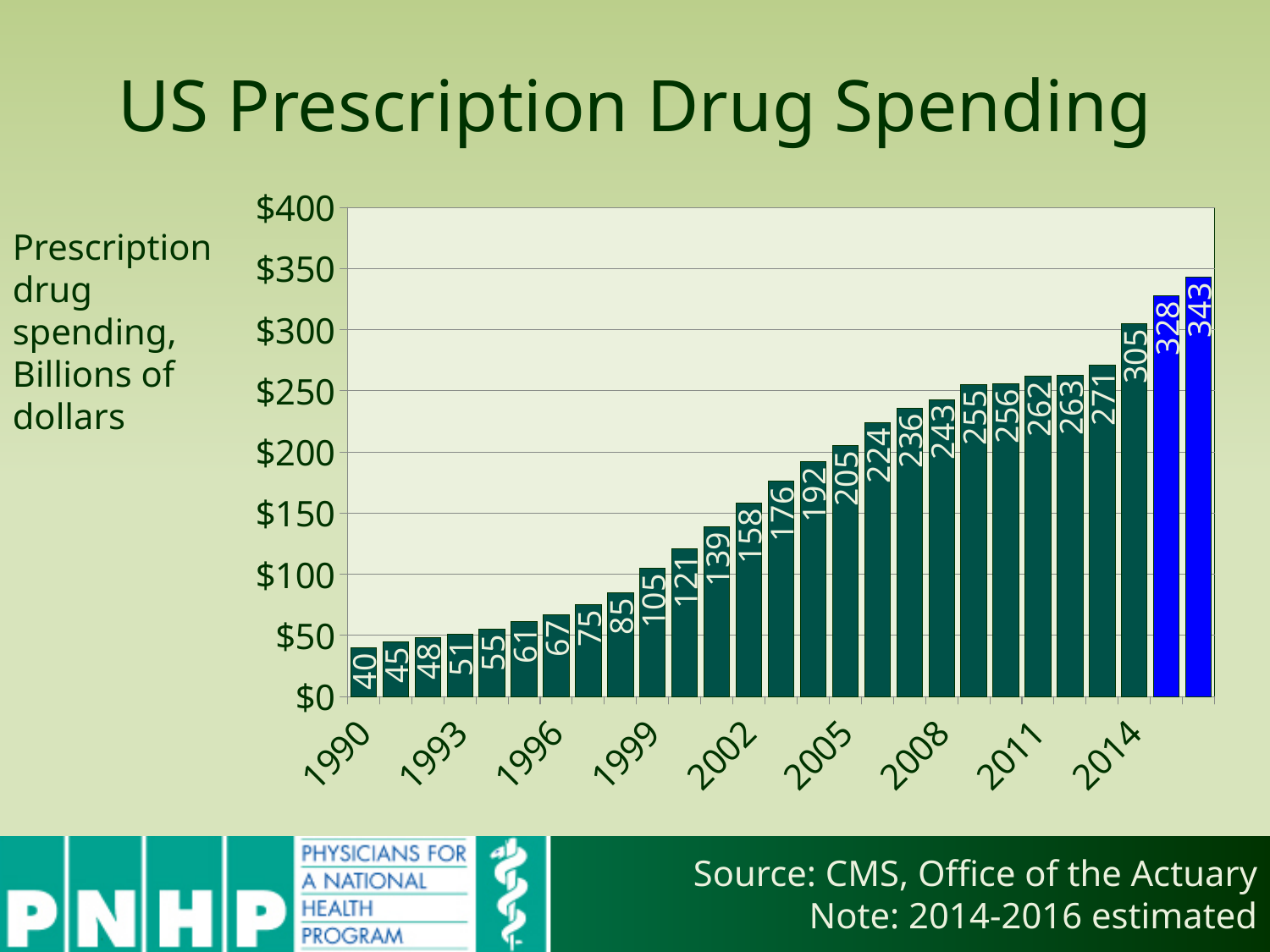
What is the value for 2014? 305 Do the values rise or fall from 1990 to the last bar? rise Which year has the lowest value? 1990 How many bars are plotted on the chart? 27 What is the highest value shown on the chart? 343 What is the value for 1990? 40 Which is larger, the value for 2008 or the value for 2002? 2008 What is the difference between the values for 2014 and 1990? 265 What kind of chart is shown? bar chart What is the value for 2005? 205 What is the value for 1999? 105 Is the value for 2011 greater or less than $250? greater